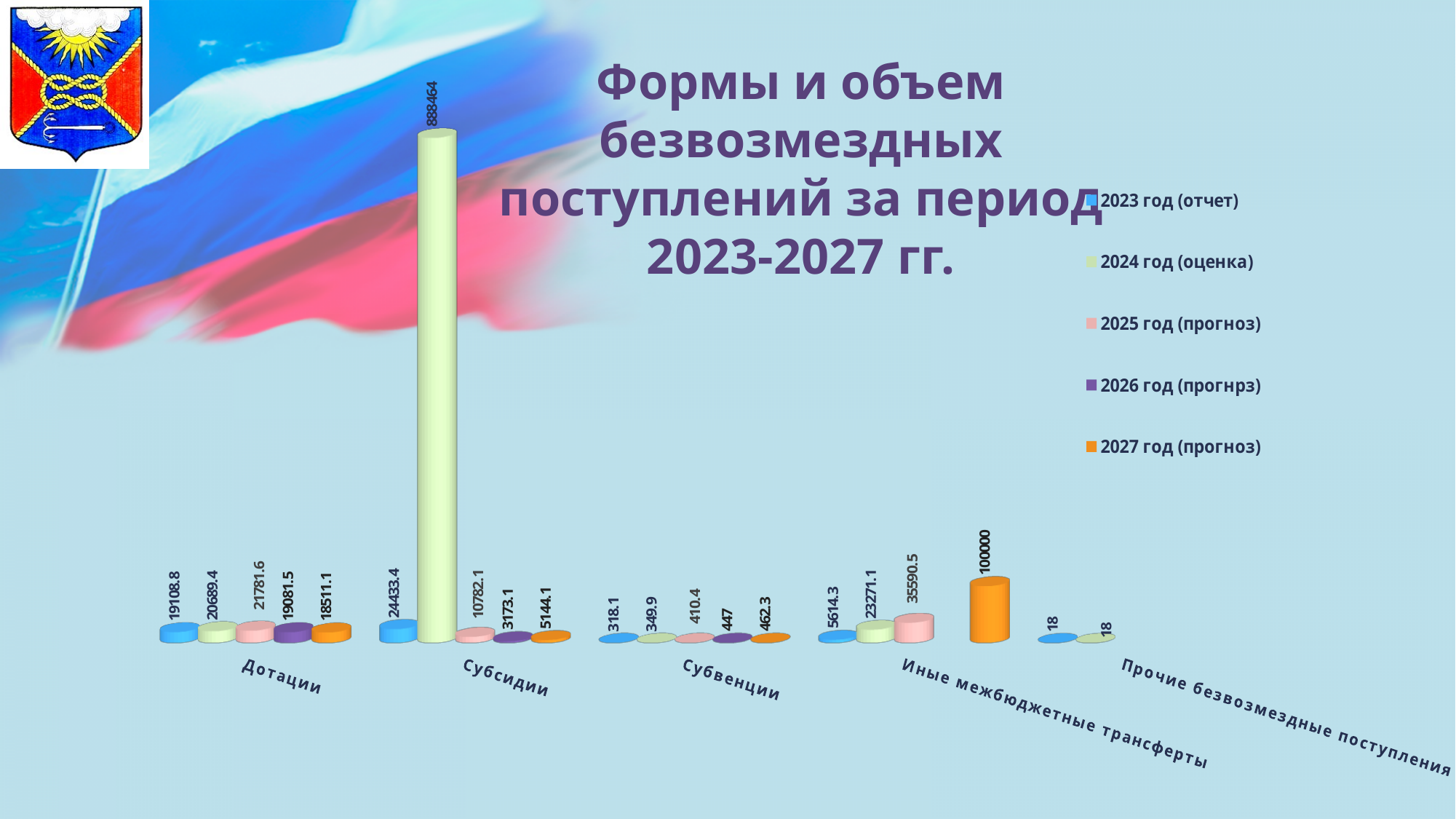
What kind of chart is shown on the slide? Bar chart How many series does the legend list? 5 Which category has the highest value in the 2024 год (оценка) series? Субсидии What is the title of the chart? Формы и объем безвозмездных поступлений за период 2023-2027 гг. What is the difference between the 2025 год (прогноз) and 2024 год (оценка) values for Дотации? 1092.2 Which category has the lowest value in the 2023 год (отчет) series? Прочие безвозмездные поступления What is the value for Дотации in the 2023 год (отчет) series? 19108.8 What is the value for Субсидии in the 2024 год (оценка) series? 888464 Do the values for Субвенции rise or fall from 2023 to 2027? Rise How many categories are shown on the x axis of the chart? 5 For Субвенции, which is larger: the 2023 год (отчет) value or the 2027 год (прогноз) value? 2027 год (прогноз) What is the value for Иные межбюджетные трансферты in the 2027 год (прогноз) series? 100000